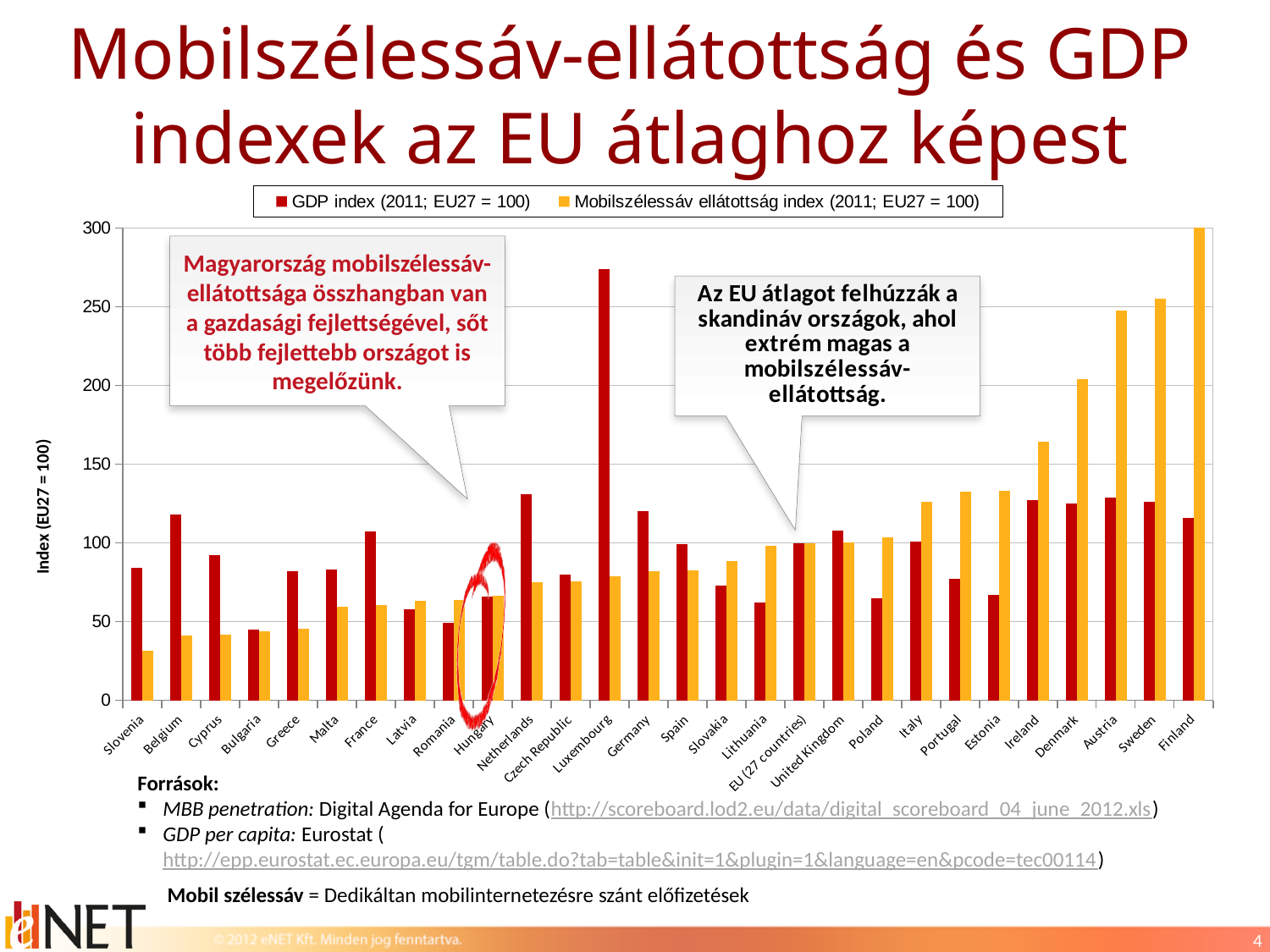
How many countries/categories are shown on the x axis? 28 What is the GDP index value for EU (27 countries)? 100 For Denmark, which is larger: the GDP index or the Mobilszélessáv ellátottság index? Mobilszélessáv ellátottság index Which colour represents the GDP index series in the legend? red Which country has the lowest Mobilszélessáv ellátottság index? Slovenia How many series does the legend list? 2 Is the GDP index for Luxembourg greater or less than 250? greater Which country has the highest Mobilszélessáv ellátottság index (2011; EU27 = 100)? Finland What kind of chart is shown on the slide? bar chart Which country has the highest GDP index (2011; EU27 = 100)? Luxembourg Is the Mobilszélessáv ellátottság index for Slovenia greater or less than 50? less Is the Mobilszélessáv ellátottság index for Finland greater or less than 250? greater